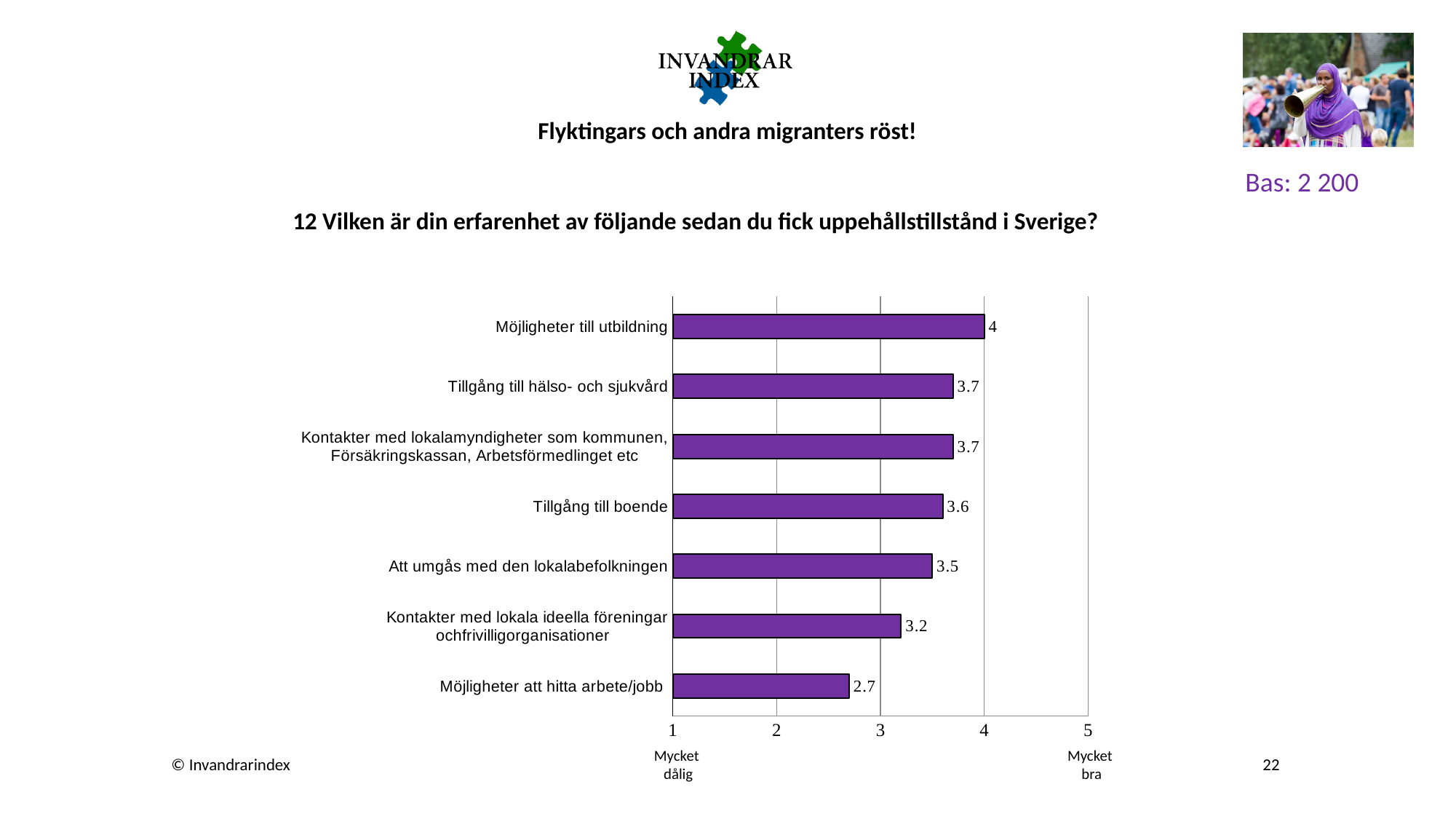
What is the value for Tillgång till boende? 3.6 Which category has the lowest value? Möjligheter att hitta arbete/jobb Which category has the highest value? Möjligheter till utbildning Is the value for Tillgång till hälso- och sjukvård greater or less than 3? greater What is the difference between the values for Möjligheter till utbildning and Möjligheter att hitta arbete/jobb? 1.3 What label appears at the right end of the x axis, under the value 5? Mycket bra Which is larger, the value for Att umgås med den lokalabefolkningen or the value for Kontakter med lokala ideella föreningar och frivilligorganisationer? Att umgås med den lokalabefolkningen How many categories are shown in the chart? 7 What is the value for Kontakter med lokala ideella föreningar och frivilligorganisationer? 3.2 What kind of chart is shown on the slide? Bar chart What is the value for Möjligheter att hitta arbete/jobb? 2.7 What is the value for Möjligheter till utbildning? 4